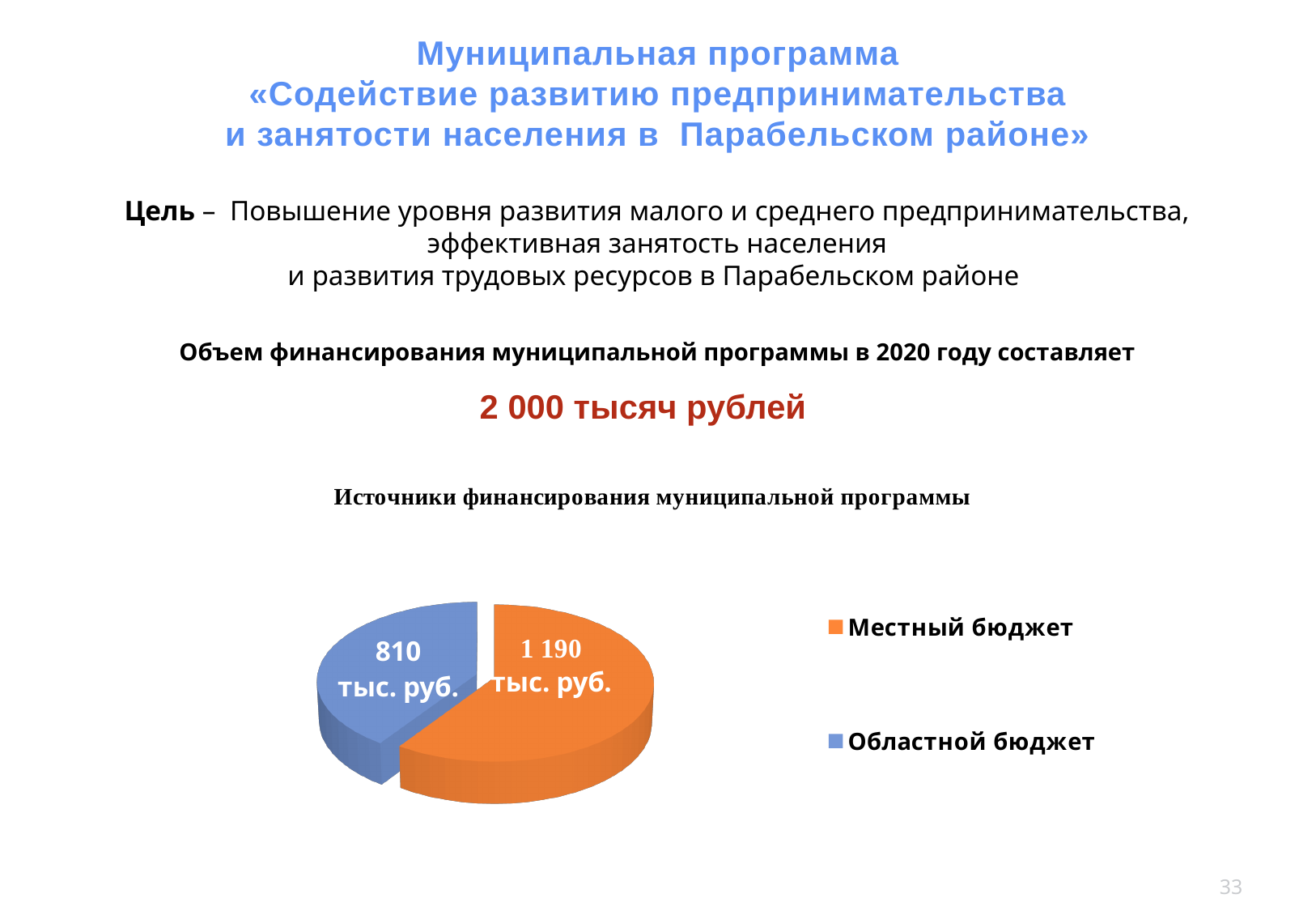
How many entries does the legend list? 2 Which funding source has the larger value? Местный бюджет Which colour represents Областной бюджет in the chart? Blue How many slices does the pie chart have? 2 What is the total of the two slices in the pie chart? 2 000 тыс. руб. What type of chart is shown on the slide? Pie chart Is the value for Местный бюджет larger or smaller than the value for Областной бюджет? Larger What is the title of the chart? Источники финансирования муниципальной программы What is the value for Областной бюджет? 810 тыс. руб. What is the value for Местный бюджет? 1 190 тыс. руб. What is the difference between Местный бюджет and Областной бюджет? 380 тыс. руб. Which funding source has the smaller value? Областной бюджет